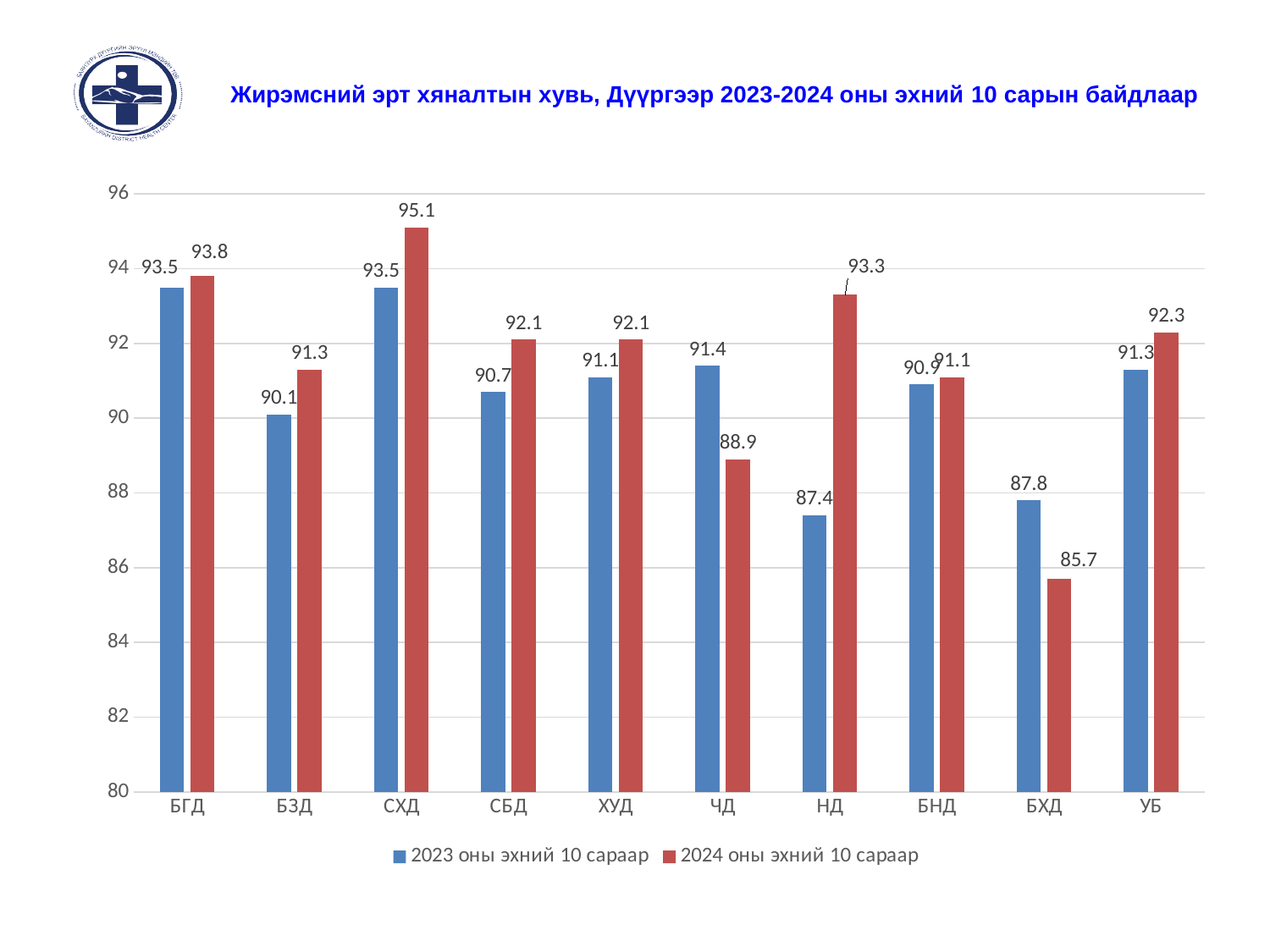
What kind of chart is shown on the slide? Bar chart What is the value for БЗД in the 2023 оны эхний 10 сараар series? 90.1 Which district has the highest value in the 2024 оны эхний 10 сараар series? СХД What is the difference between the 2023 and 2024 values for БХД? 2.1 Which district has the lowest value in the 2023 оны эхний 10 сараар series? НД Is the 2024 оны эхний 10 сараар value for СХД greater or less than 94? greater Which district has the lowest value in the 2024 оны эхний 10 сараар series? БХД What is the value for НД in the 2024 оны эхний 10 сараар series? 93.3 How many districts are shown on the x axis? 10 How many series does the legend list? 2 For ЧД, which series has the larger value, 2023 оны эхний 10 сараар or 2024 оны эхний 10 сараар? 2023 оны эхний 10 сараар What is the difference between the 2024 and 2023 values for НД? 5.9